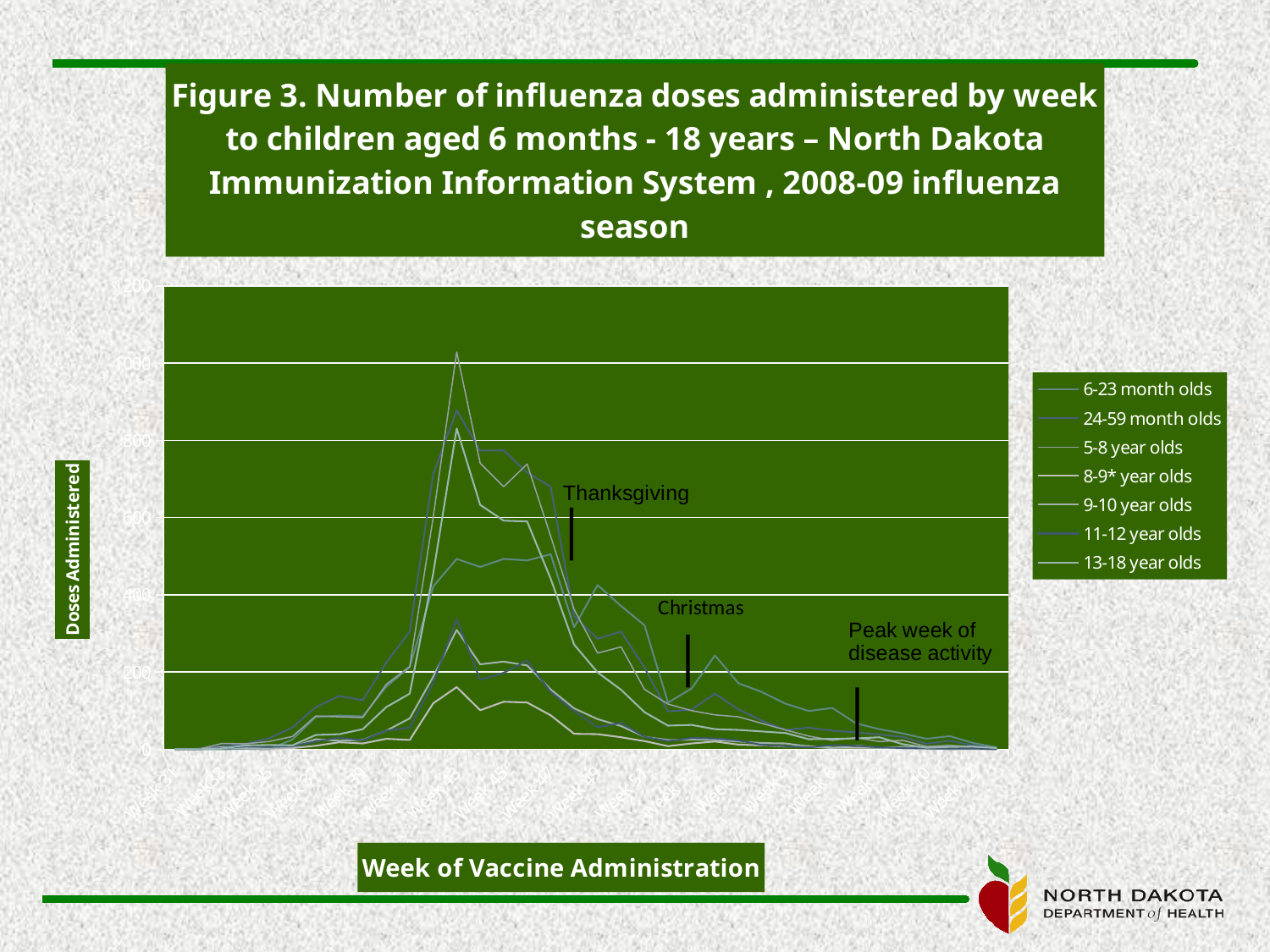
How many series does the legend list? 7 After the peak in the middle of the chart, do the values rise or fall toward the right end of the x axis? fall Which legend entry is marked with an asterisk? 8-9* year olds Is the highest value plotted on the chart greater or less than 1200? less What is the title of the vertical axis? Doses Administered Is the highest value plotted on the chart greater or less than 800? greater What kind of chart is shown on the slide? line chart